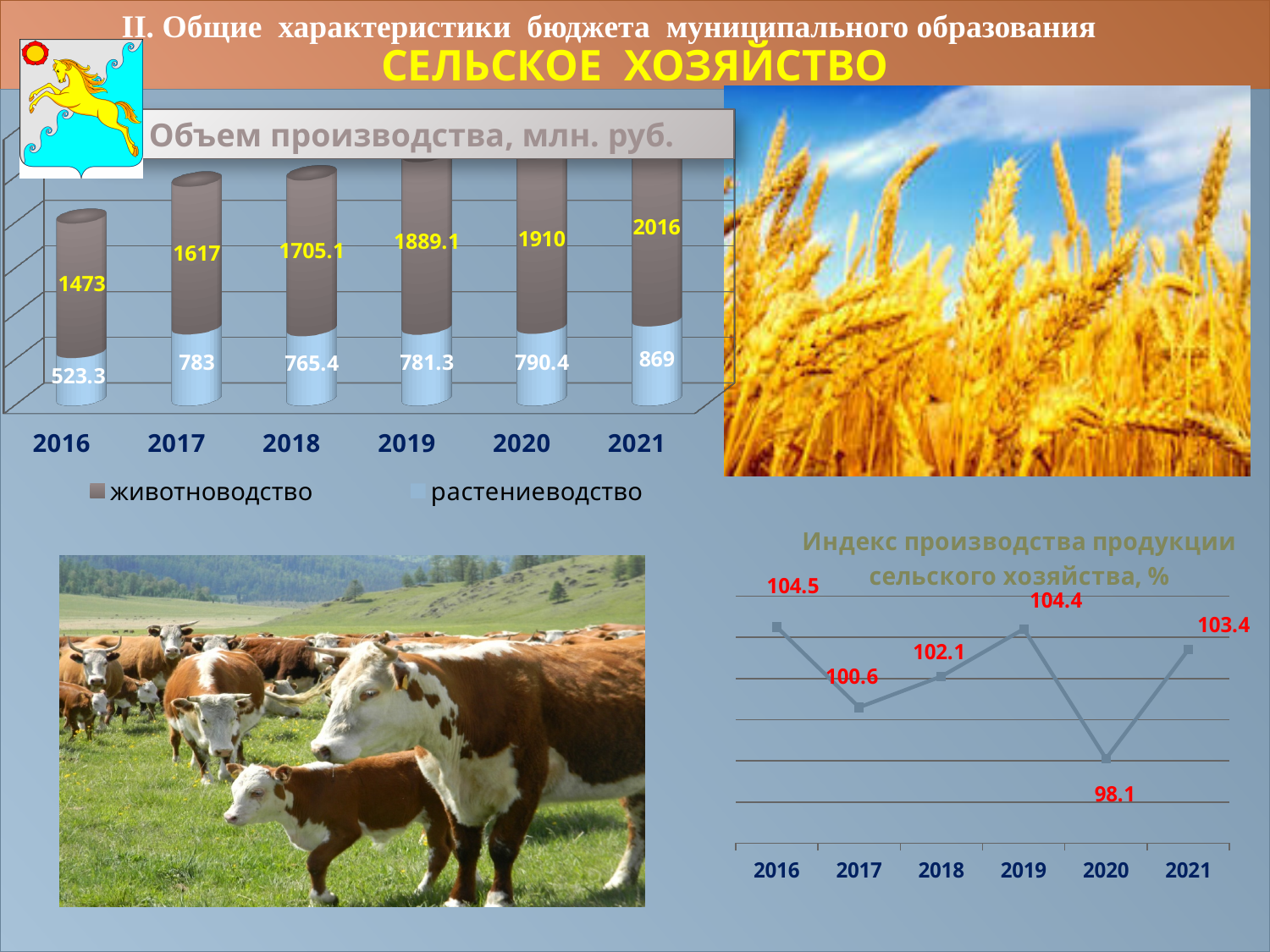
In the chart 'Индекс производства продукции сельского хозяйства, %', what is the value for 2020? 98.1 What kind of chart is 'Индекс производства продукции сельского хозяйства, %'? line chart In the chart 'Объем производства, млн. руб.', what is the total of the stacked bar for 2021? 2885 In the chart 'Индекс производства продукции сельского хозяйства, %', which year has the highest value? 2016 In the chart 'Объем производства, млн. руб.', which year has the highest value for животноводство? 2021 In the chart 'Объем производства, млн. руб.', which year has the lowest value for растениеводство? 2016 In the chart 'Объем производства, млн. руб.', what is the value for животноводство in 2019? 1889.1 In the chart 'Индекс производства продукции сельского хозяйства, %', what is the difference between the 2016 and 2020 values? 6.4 In the chart 'Объем производства, млн. руб.', how many series does the legend list? 2 In the chart 'Объем производства, млн. руб.', what is the value for растениеводство in 2021? 869 In the chart 'Объем производства, млн. руб.', by how much did животноводство increase from 2016 to 2021? 543 In the chart 'Объем производства, млн. руб.', does the value for животноводство rise or fall from 2016 to 2021? rise